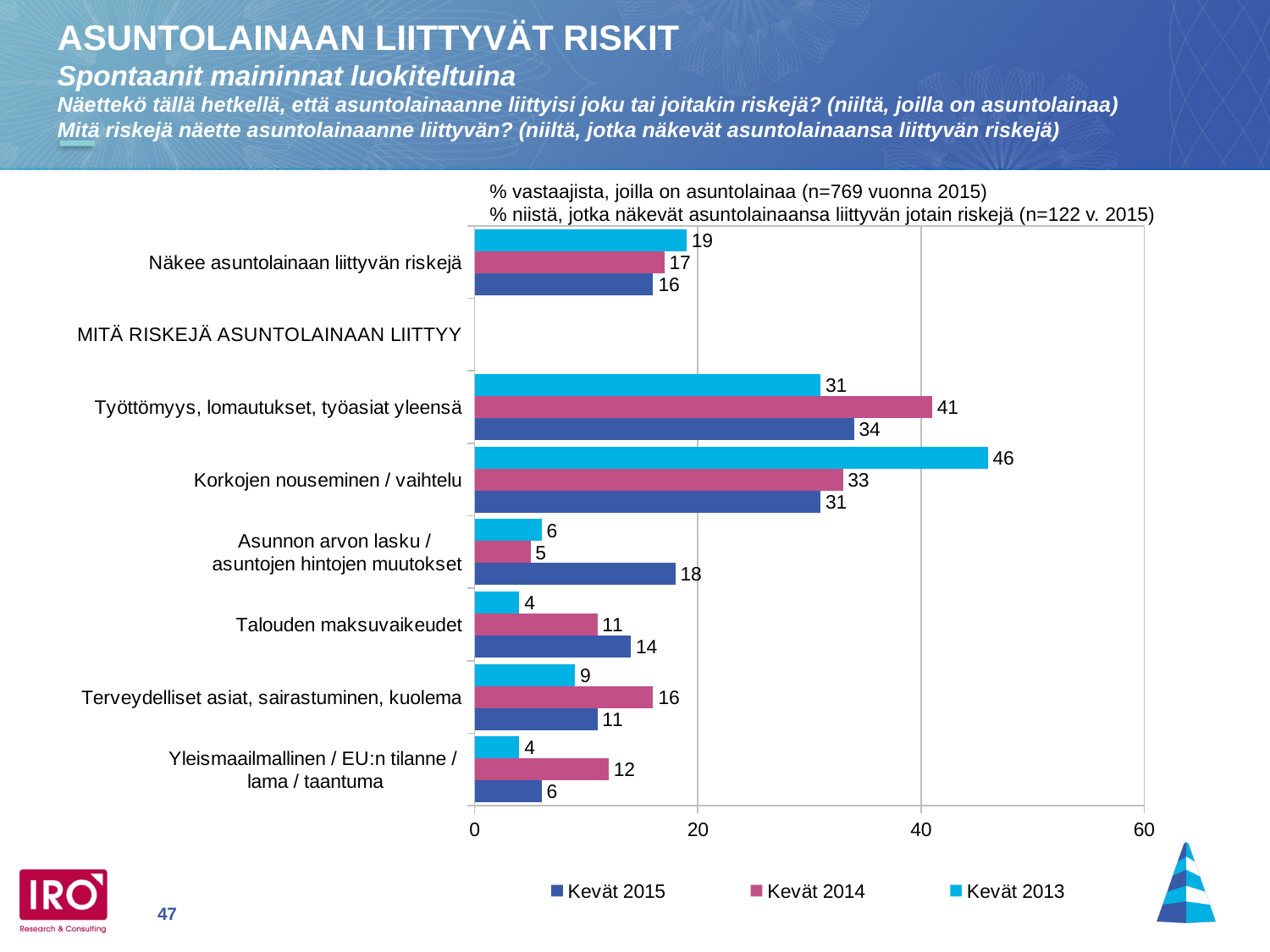
Which risk category has the highest Kevät 2014 value? Työttömyys, lomautukset, työasiat yleensä What is the Kevät 2015 value for Asunnon arvon lasku / asuntojen hintojen muutokset? 18 What is the Kevät 2013 value for Korkojen nouseminen / vaihtelu? 46 Is the Kevät 2014 value for Työttömyys, lomautukset, työasiat yleensä greater or less than 40? greater What is the difference between the Kevät 2013 and Kevät 2015 values for Korkojen nouseminen / vaihtelu? 15 What kind of chart is shown on the slide? bar chart How many series does the legend list? 3 Which series is shown in the legend with the light blue colour? Kevät 2013 Which risk category has the lowest Kevät 2015 value? Yleismaailmallinen / EU:n tilanne / lama / taantuma What is the Kevät 2015 value for Työttömyys, lomautukset, työasiat yleensä? 34 Which is larger for Talouden maksuvaikeudet: the Kevät 2014 value or the Kevät 2015 value? Kevät 2015 What is the Kevät 2014 value for Terveydelliset asiat, sairastuminen, kuolema? 16